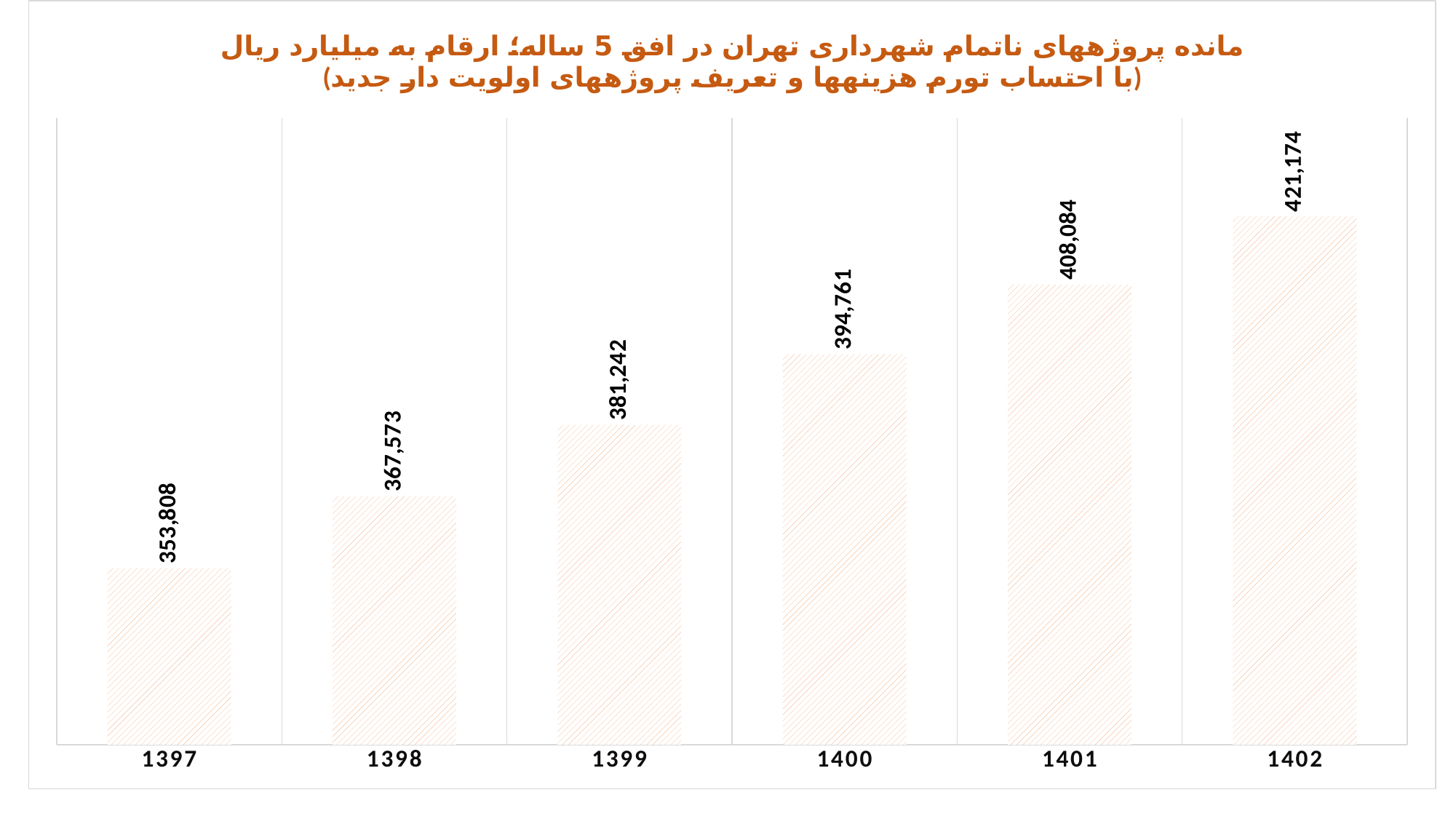
Do the values rise or fall from 1397 to 1402? rise What is the value for 1401? 408,084 Which is larger, the value for 1400 or the value for 1398? 1400 What is the value for 1397? 353,808 What is the difference between the values for 1402 and 1397? 67,366 What is the value for 1399? 381,242 What kind of chart is this? bar chart What is the value for 1402? 421,174 Which year has the highest value? 1402 How many years are shown on the x axis? 6 What is the difference between the values for 1398 and 1397? 13,765 Which year has the lowest value? 1397